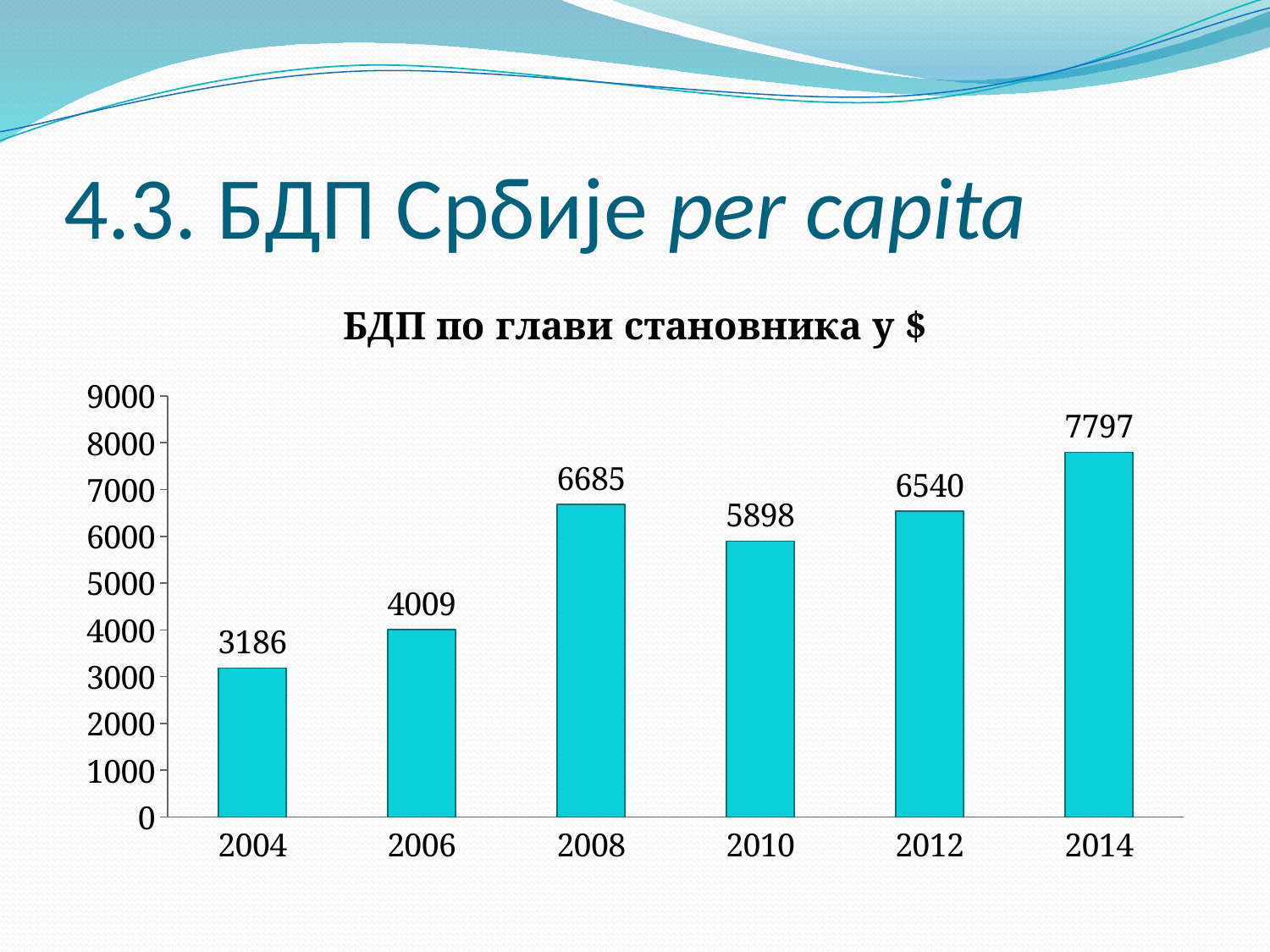
What is the title of the chart? БДП по глави становника у $ Which year has the highest value? 2014 What kind of chart is shown on the slide? bar chart Is the value for 2010 greater or less than 5000? greater Which year has the lowest value? 2004 What is the value shown for 2004? 3186 How many years are shown on the x axis? 6 Which is larger, the value for 2008 or the value for 2012? 2008 What is the GDP per capita value shown for 2008? 6685 What is the difference between the values for 2014 and 2004? 4611 What is the value shown for 2012? 6540 What is the difference between the values for 2008 and 2010? 787